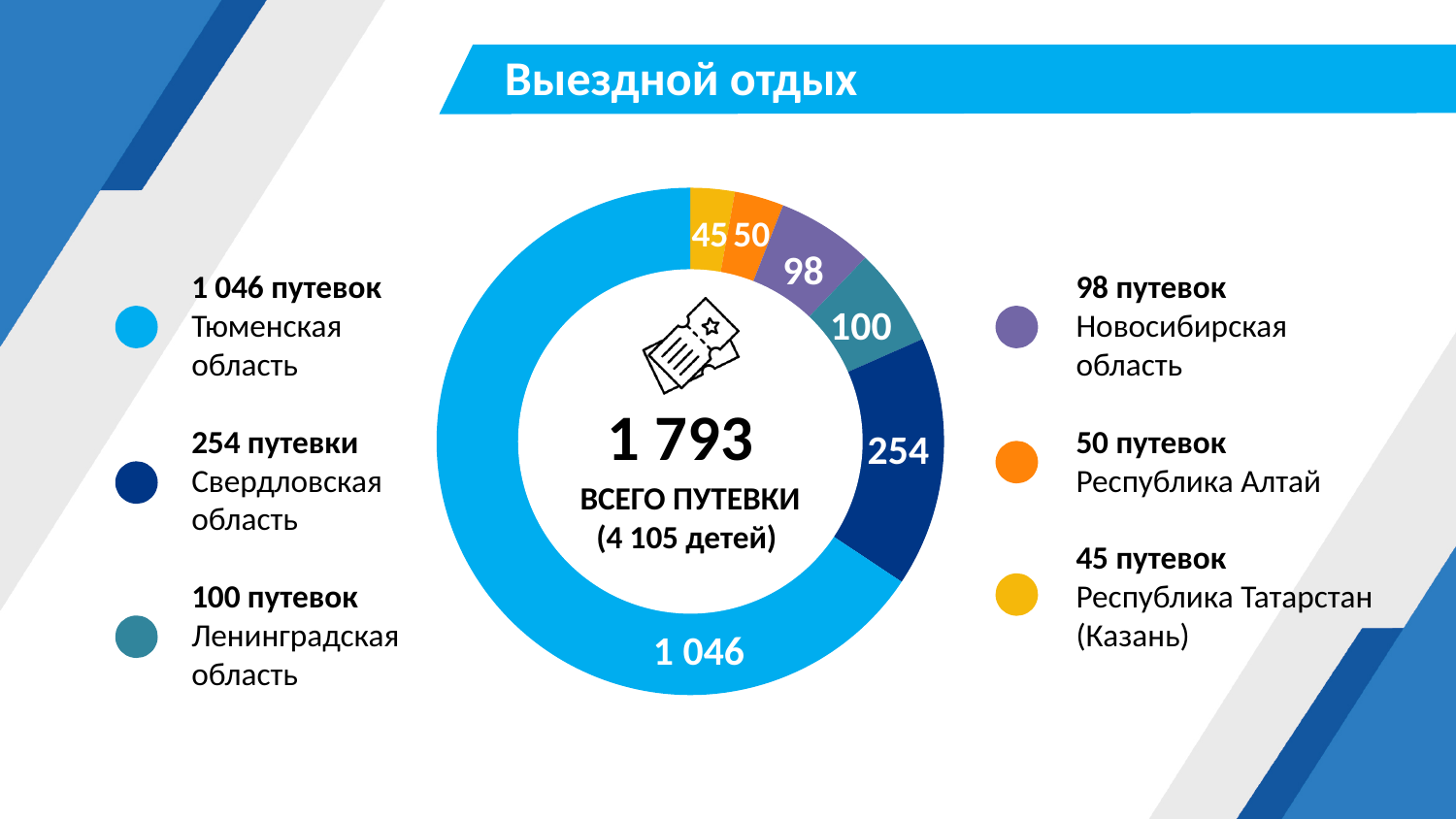
How many путевок are shown for Тюменская область? 1 046 What total number of путевки is printed in the centre of the donut chart? 1 793 How many regions (segments) does the donut chart show? 6 What is the difference between the values for Свердловская область and Ленинградская область? 154 How many путевок are shown for Республика Алтай? 50 Which region has the smallest segment in the donut chart? Республика Татарстан (Казань) What is the title of the slide containing the chart? Выездной отдых What type of chart is shown on the slide? Donut (pie) chart Which region has the largest segment in the donut chart? Тюменская область Which is larger: the value for Ленинградская область or Новосибирская область? Ленинградская область How many путевок are shown for Свердловская область? 254 What is the difference between the values for Новосибирская область and Республика Алтай? 48